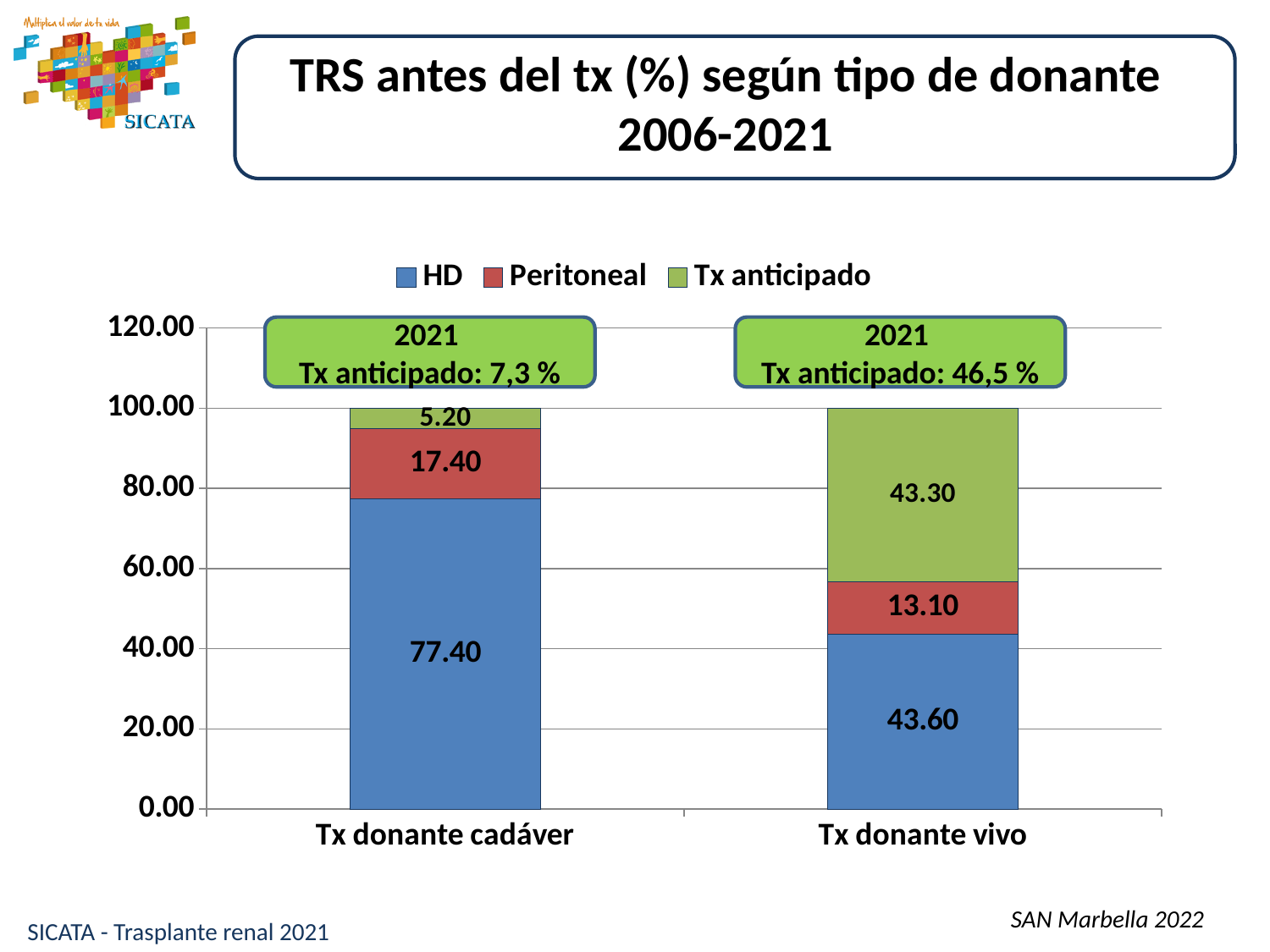
What is the Tx anticipado value for Tx donante cadáver? 5.20 What is the Tx anticipado value for Tx donante vivo? 43.30 What is the total of the stacked bar for Tx donante cadáver? 100.00 How many categories are shown on the x axis? 2 What is the title of the chart? TRS antes del tx (%) según tipo de donante 2006-2021 What kind of chart is shown? Stacked bar chart Which category has the higher HD value? Tx donante cadáver What is the HD value for Tx donante cadáver? 77.40 What is the total of the stacked bar for Tx donante vivo? 100.00 What is the Peritoneal value for Tx donante vivo? 13.10 How many series does the legend list? 3 What is the difference between the Tx anticipado values for Tx donante vivo and Tx donante cadáver? 38.10